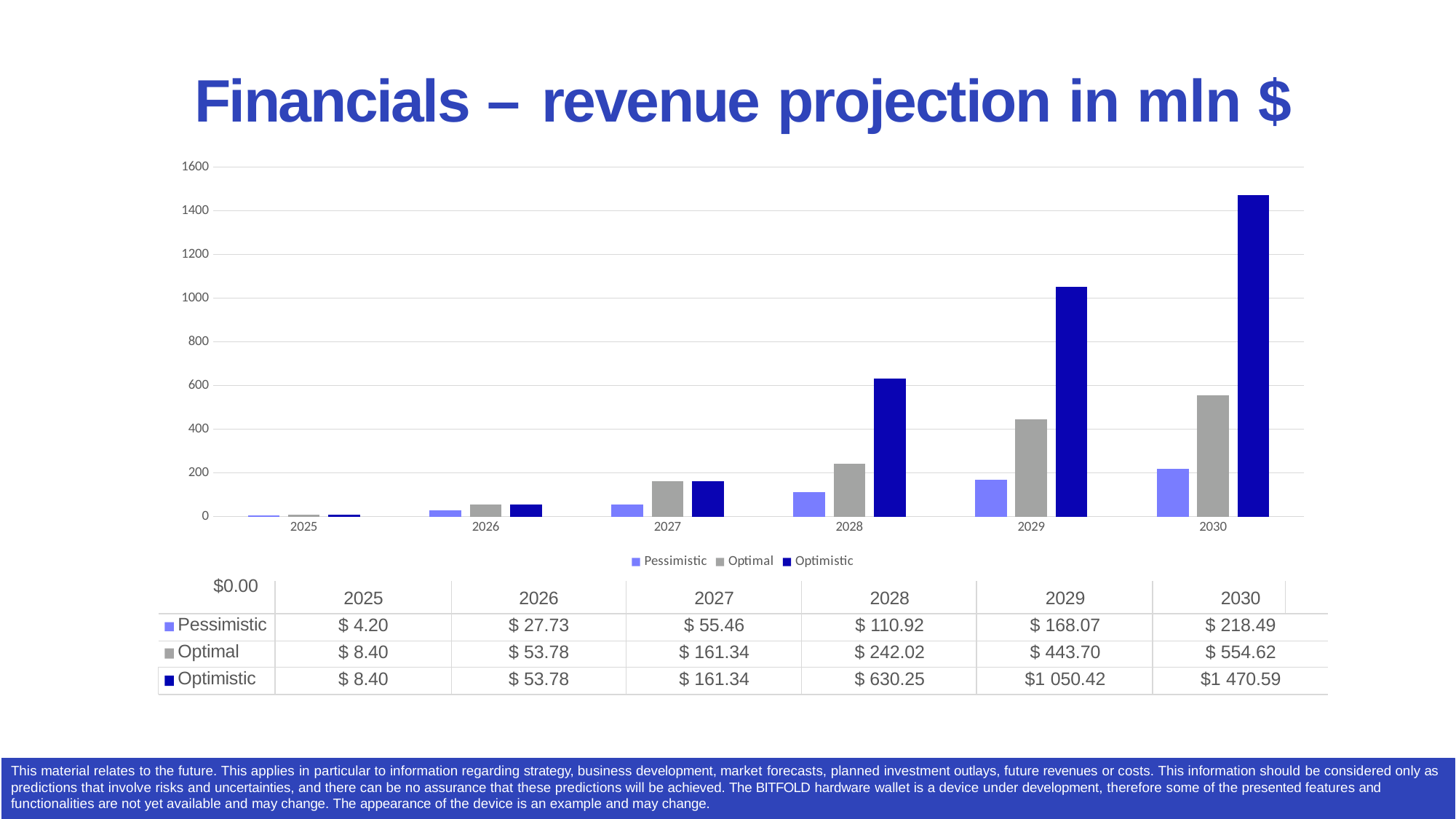
Is the Optimistic value for 2030 greater or less than 1400? greater How many series does the legend list? 3 Which year has the highest Optimistic revenue projection? 2030 How many years are shown on the x axis of the chart? 6 Do the Optimal projections rise or fall from 2025 to 2030? rise What kind of chart is shown on the slide? bar chart What is the difference between the Optimistic and Optimal projections for 2030? $ 915.97 What is the Optimistic revenue projection for 2029? $1 050.42 What is the Pessimistic revenue projection for 2030? $ 218.49 Which year has the lowest Pessimistic revenue projection? 2025 Which is larger in 2028, the Optimal projection or the Optimistic projection? Optimistic What is the Optimal revenue projection for 2027? $ 161.34